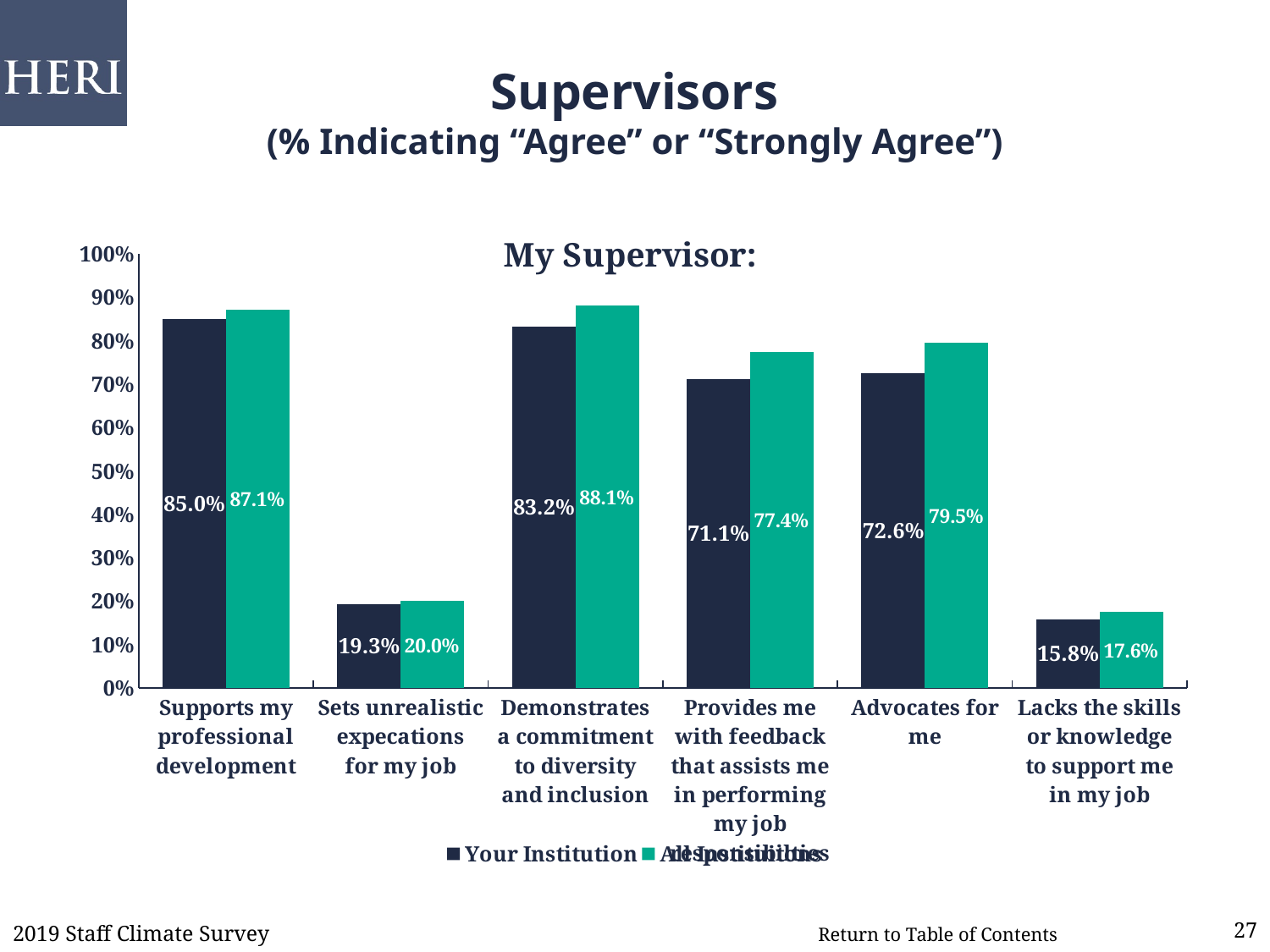
How many series does the chart's legend list? 2 What is the difference between the teal and navy values for 'Advocates for me'? 6.9% For 'Sets unrealistic expecations for my job', which is larger: the Your Institution value or the teal (All Institutions) value? All Institutions (teal), 20.0% Which category has the lowest teal (All Institutions) value? Lacks the skills or knowledge to support me in my job What type of chart is shown on the slide? bar chart What percentage of Your Institution respondents agree that their supervisor supports their professional development? 85.0% Is the Your Institution value for 'Lacks the skills or knowledge to support me in my job' greater or less than 20%? less How many categories are shown on the x axis of the chart? 6 What is the title printed above the plot area of the chart? My Supervisor: What is the teal (All Institutions) value for 'Demonstrates a commitment to diversity and inclusion'? 88.1% Which category has the highest Your Institution value? Supports my professional development What is the Your Institution value for 'Provides me with feedback that assists me in performing my job'? 71.1%